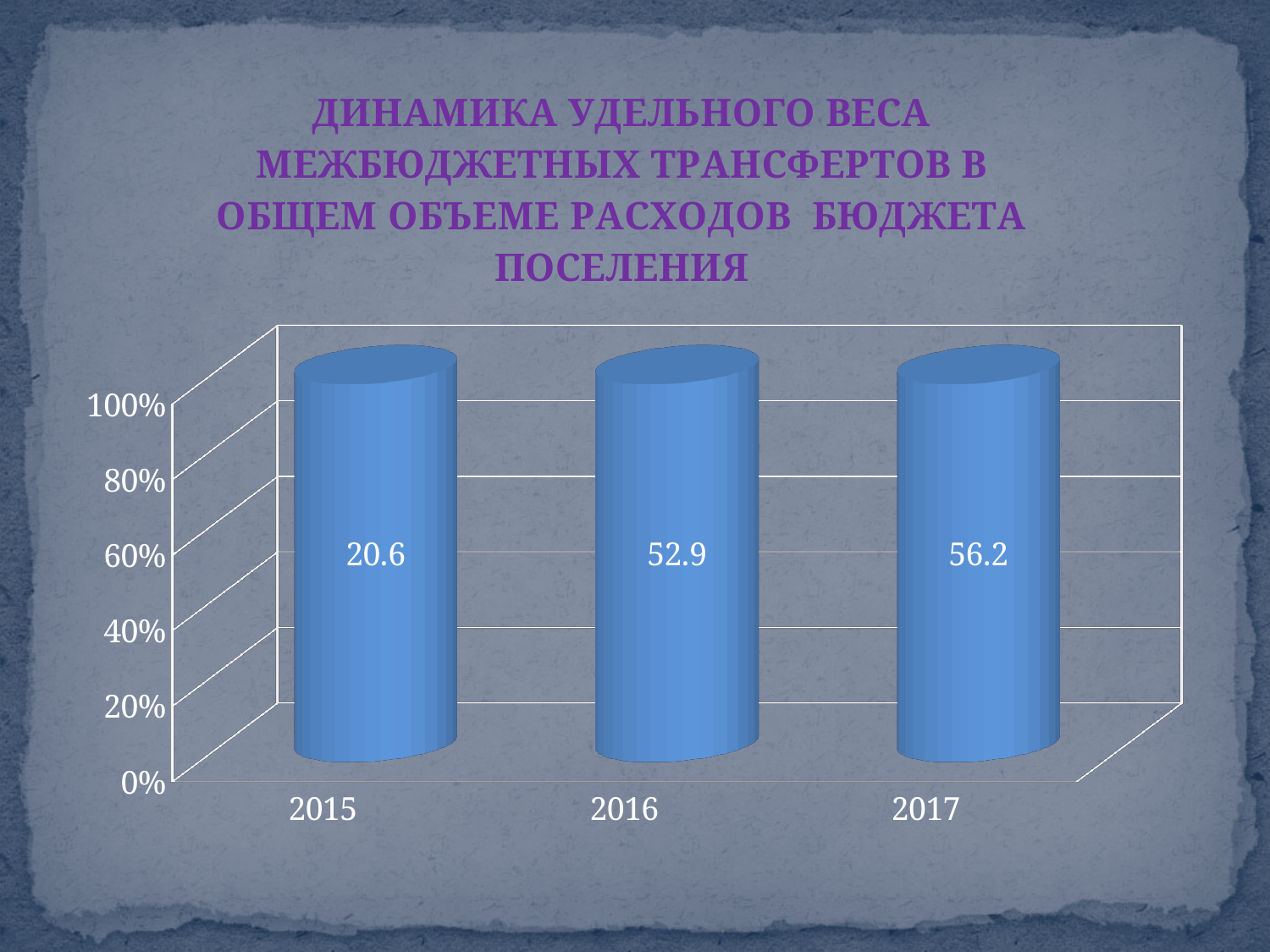
What is the difference between the labelled values for 2017 and 2016? 3.3 Which year has the lowest labelled value? 2015 What value is labelled on the bar for 2017? 56.2 Do the labelled values rise or fall from 2015 to 2017? rise What value is labelled on the bar for 2015? 20.6 What is the difference between the labelled values for 2017 and 2015? 35.6 What kind of chart is shown on the slide? bar chart Which year has the larger labelled value, 2015 or 2016? 2016 How many years are shown on the x axis? 3 What value is labelled on the bar for 2016? 52.9 What is the difference between the labelled values for 2016 and 2015? 32.3 Which year has the highest labelled value? 2017